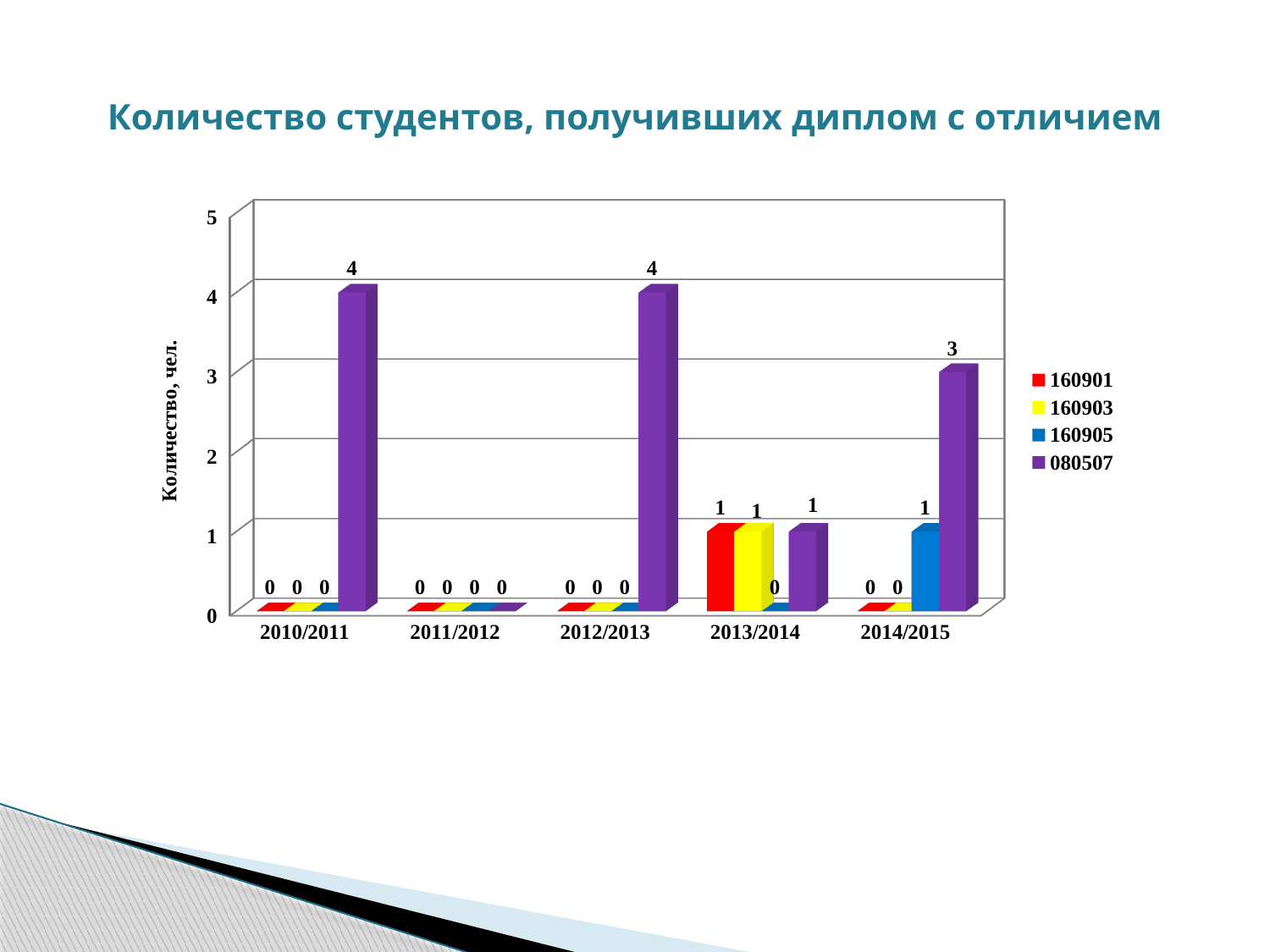
What type of chart is shown on the slide? bar chart What is the value for series 080507 in 2014/2015? 3 What is the title of the chart on the slide? Количество студентов, получивших диплом с отличием What is the value for series 160901 in 2013/2014? 1 What is the total of all four series in 2013/2014? 3 How many academic years are shown on the x axis? 5 What is the difference between the 080507 value in 2012/2013 and in 2014/2015? 1 What is the value for series 160905 in 2014/2015? 1 How many series does the legend list? 4 In which academic year are all four series equal to 0? 2011/2012 Which is larger: the 080507 value in 2013/2014 or the 080507 value in 2014/2015? 2014/2015 What is the value for series 080507 in 2010/2011? 4